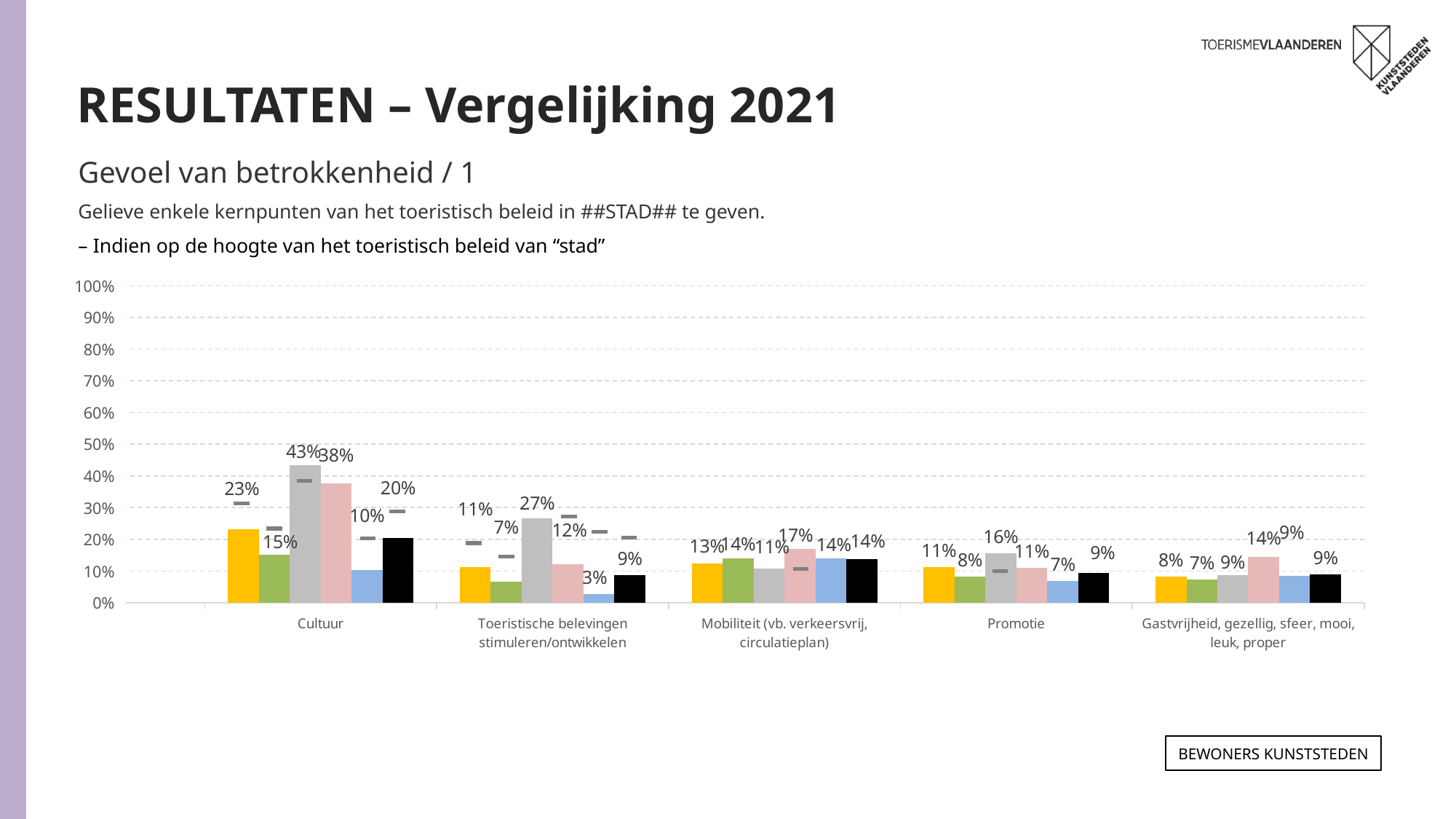
What is the value of the grey bar for Promotie? 16% What is the difference between the grey bar and the pink bar for Cultuur? 5% What type of chart is shown on the slide? bar chart Which category has the highest grey bar? Cultuur Which category has the lowest blue bar? Toeristische belevingen stimuleren/ontwikkelen What is the value of the black bar for Toeristische belevingen stimuleren/ontwikkelen? 9% Which is larger for Promotie: the yellow bar or the green bar? the yellow bar What is the value of the pink bar for Cultuur? 38% What is the value of the grey bar for Cultuur? 43% What is the value of the pink bar for Mobiliteit (vb. verkeersvrij, circulatieplan)? 17% Is the value of the grey bar for Cultuur greater or less than 40%? greater How many categories are shown along the x axis of the chart? 5